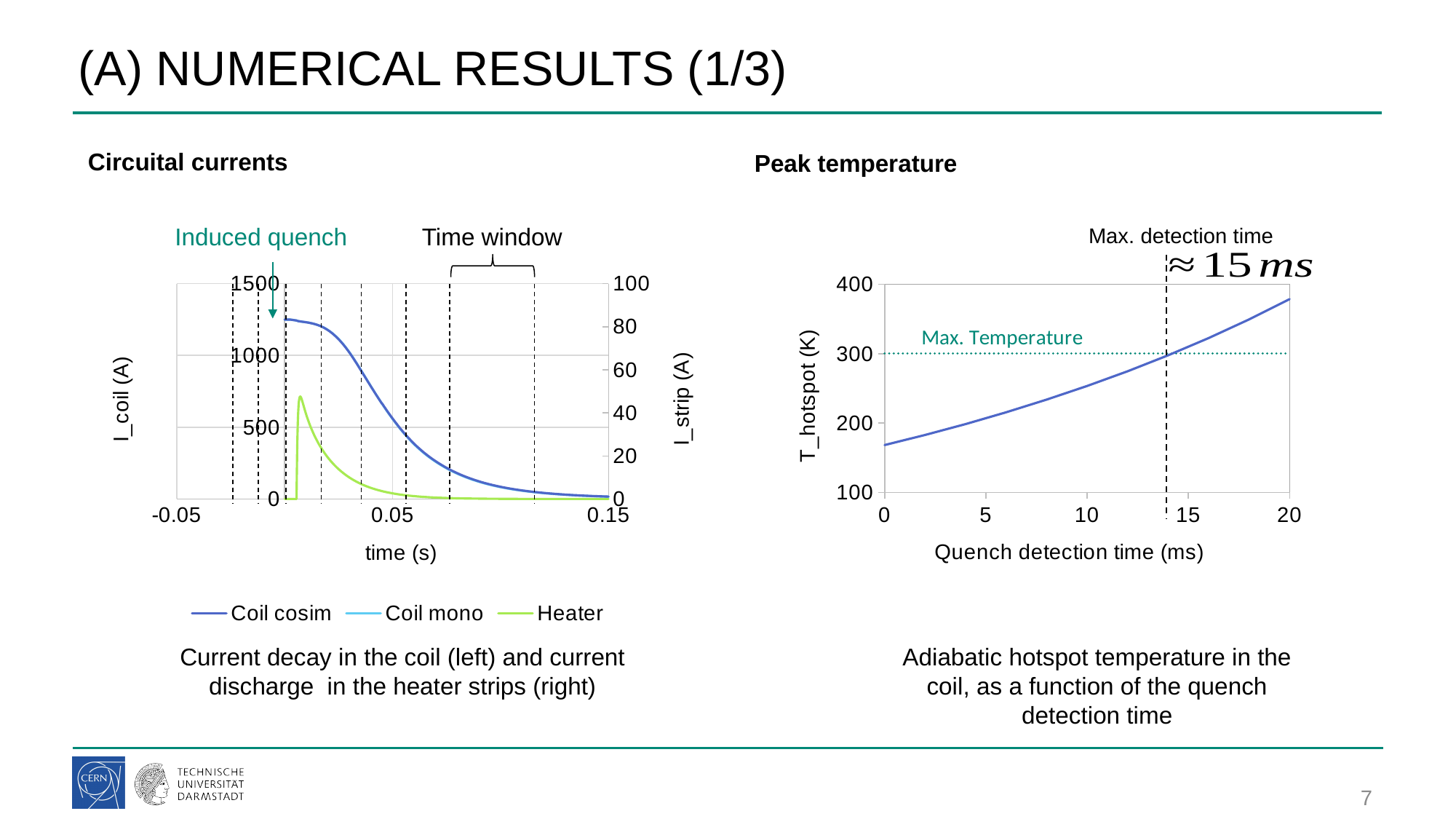
In the 'Circuital currents' chart, does the Coil cosim current rise or fall as time increases after the quench? fall In the 'Circuital currents' chart, is the peak Heater current greater or less than 60 A? less What kind of chart is the 'Circuital currents' chart on the left? line chart In the 'Peak temperature' chart, does the hotspot temperature rise or fall as the quench detection time increases? rise In the 'Circuital currents' chart, is the Coil cosim current at time 0 s greater or less than 1000 A? greater How many series does the legend of the 'Circuital currents' chart list? 3 What kind of chart is the 'Peak temperature' chart on the right? line chart In the 'Peak temperature' chart, is the hotspot temperature at a quench detection time of 0 ms greater or less than 200 K? less In the 'Peak temperature' chart, at what temperature is the dotted 'Max. Temperature' line drawn? 300 In the 'Circuital currents' chart, what are the three legend entries? Coil cosim, Coil mono, Heater What is the x-axis label of the 'Peak temperature' chart? Quench detection time (ms)